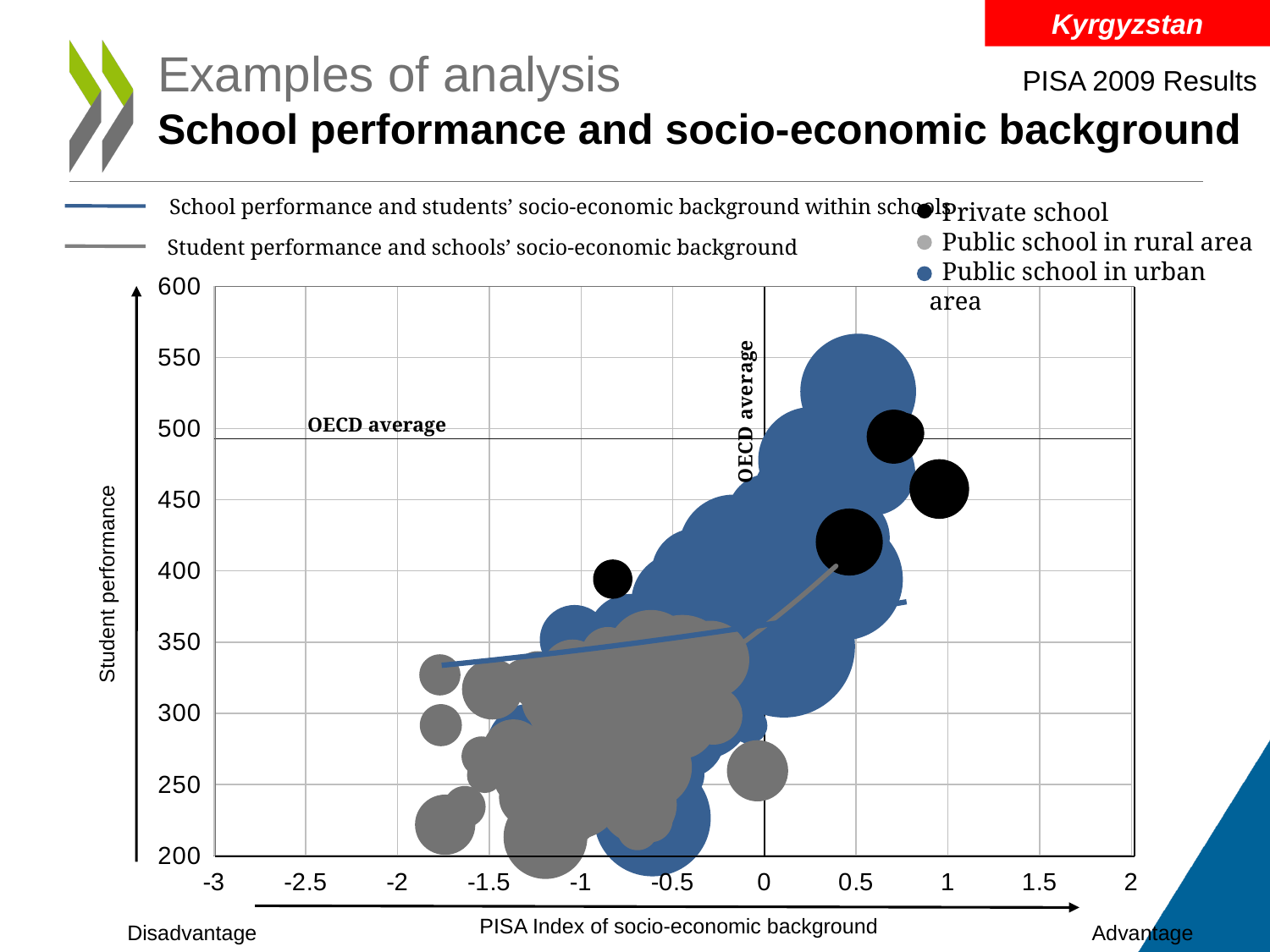
Which series contains the bubble with the highest student performance: Private school or Public school in urban area? Public school in urban area What is the label of the horizontal axis? PISA Index of socio-economic background Is the student performance of the highest Public school in urban area bubble greater or less than 500? greater Is the student performance of the Public school in rural area bubble located near a socio-economic index of 0 greater or less than 300? less Is the student performance of the Private school bubble located near a socio-economic index of 1 greater or less than 400? greater How many series does the bubble legend list (Private school, Public school in rural area, Public school in urban area)? 3 What kind of chart is shown on the slide? bubble chart How many tick labels are shown on the horizontal axis from -3 to 2? 11 Does student performance generally rise or fall as the PISA index of socio-economic background increases? rise What is the label of the vertical axis? Student performance